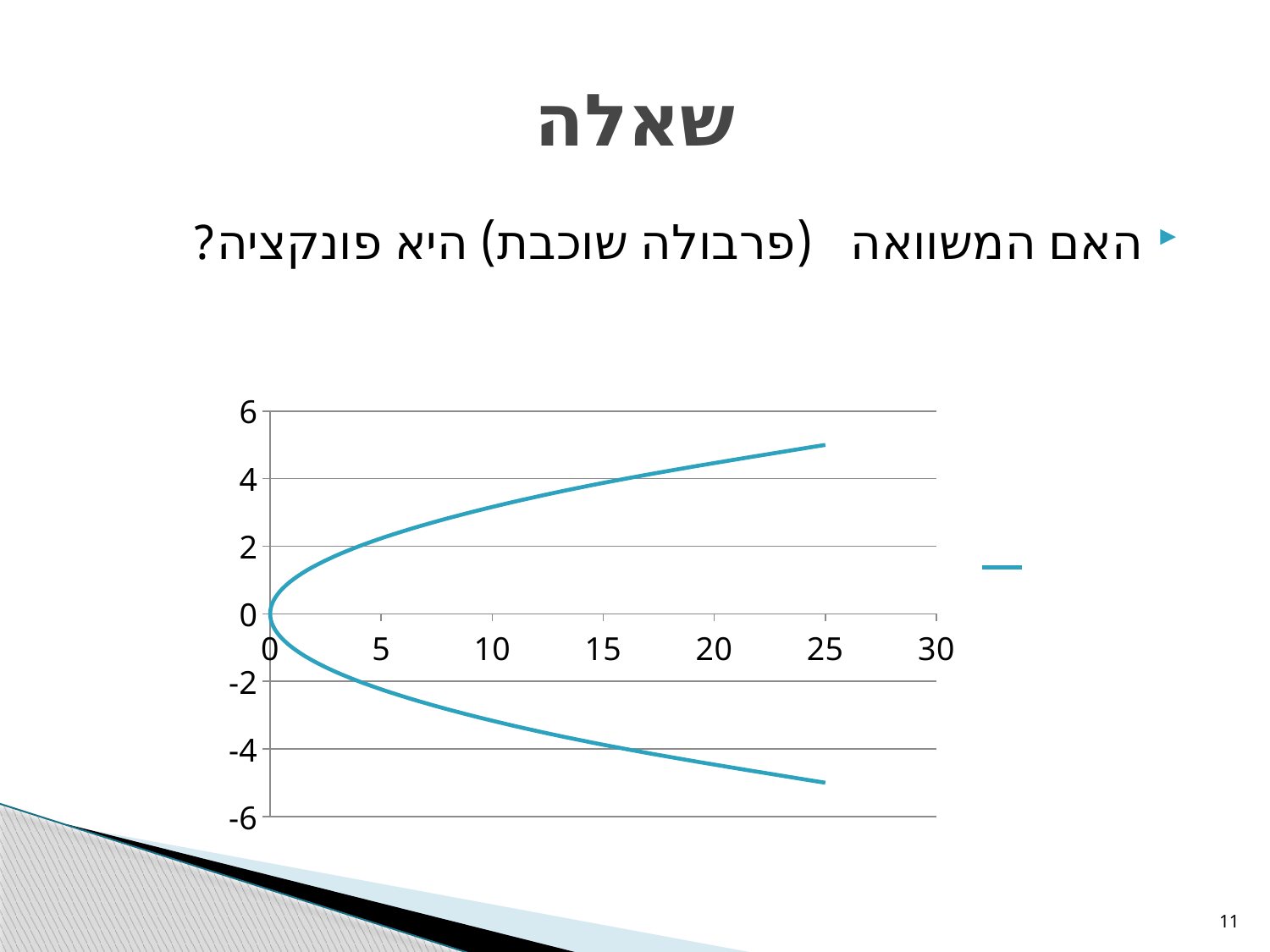
Is the value of the lower branch of the curve at x = 25 greater or less than -4? less What is the highest value shown on the x axis? 30 How many series does the legend list? 1 Is the value of the upper branch of the curve at x = 25 greater or less than 4? greater Does the chart show bars, lines, or pie slices? lines At what x value does the curve reach its leftmost point (the vertex)? 0 Is the value of the upper branch of the curve at x = 5 greater or less than 4? less What is the largest x value the curve reaches? 25 What is the lowest value shown on the y axis? -6 Does the lower branch of the curve rise or fall as x increases? fall Does the upper branch of the curve rise or fall as x increases? rise What is the y value of the curve at its leftmost point (the vertex)? 0